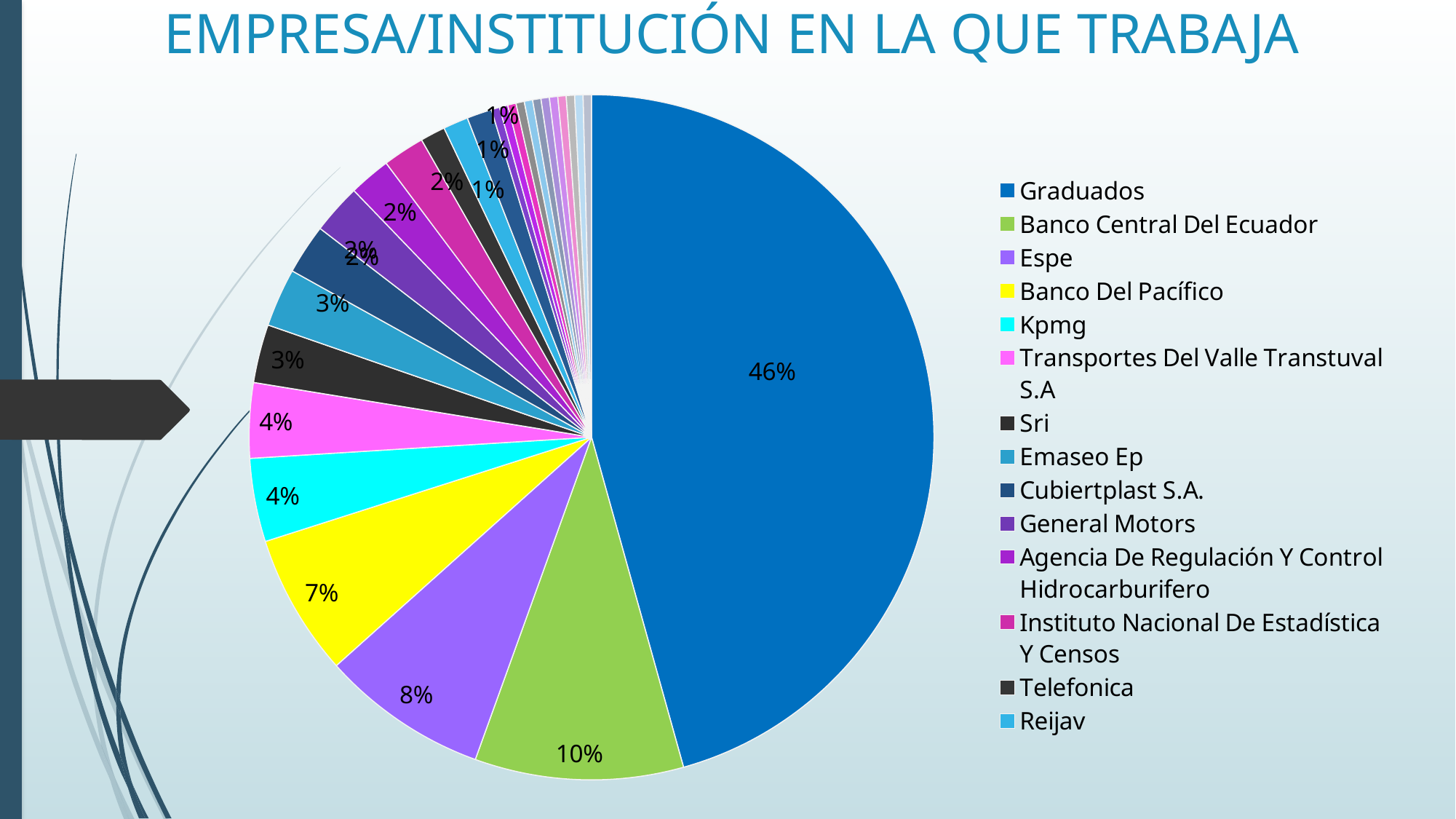
What percentage is shown for Banco Del Pacífico? 7% What percentage is shown for Banco Central Del Ecuador? 10% What is the difference in percentage points between Graduados and Banco Central Del Ecuador? 36 What type of chart is shown on the slide? pie chart How many entries are listed in the legend? 14 Which category has the largest slice of the pie? Graduados Which is larger, the slice for Espe or the slice for Banco Del Pacífico? Espe What percentage is shown for Espe? 8% What share of the pie does Graduados represent? 46% What percentage is shown for Kpmg? 4% What is the title of the chart? EMPRESA/INSTITUCIÓN EN LA QUE TRABAJA What percentage is shown for Sri? 3%